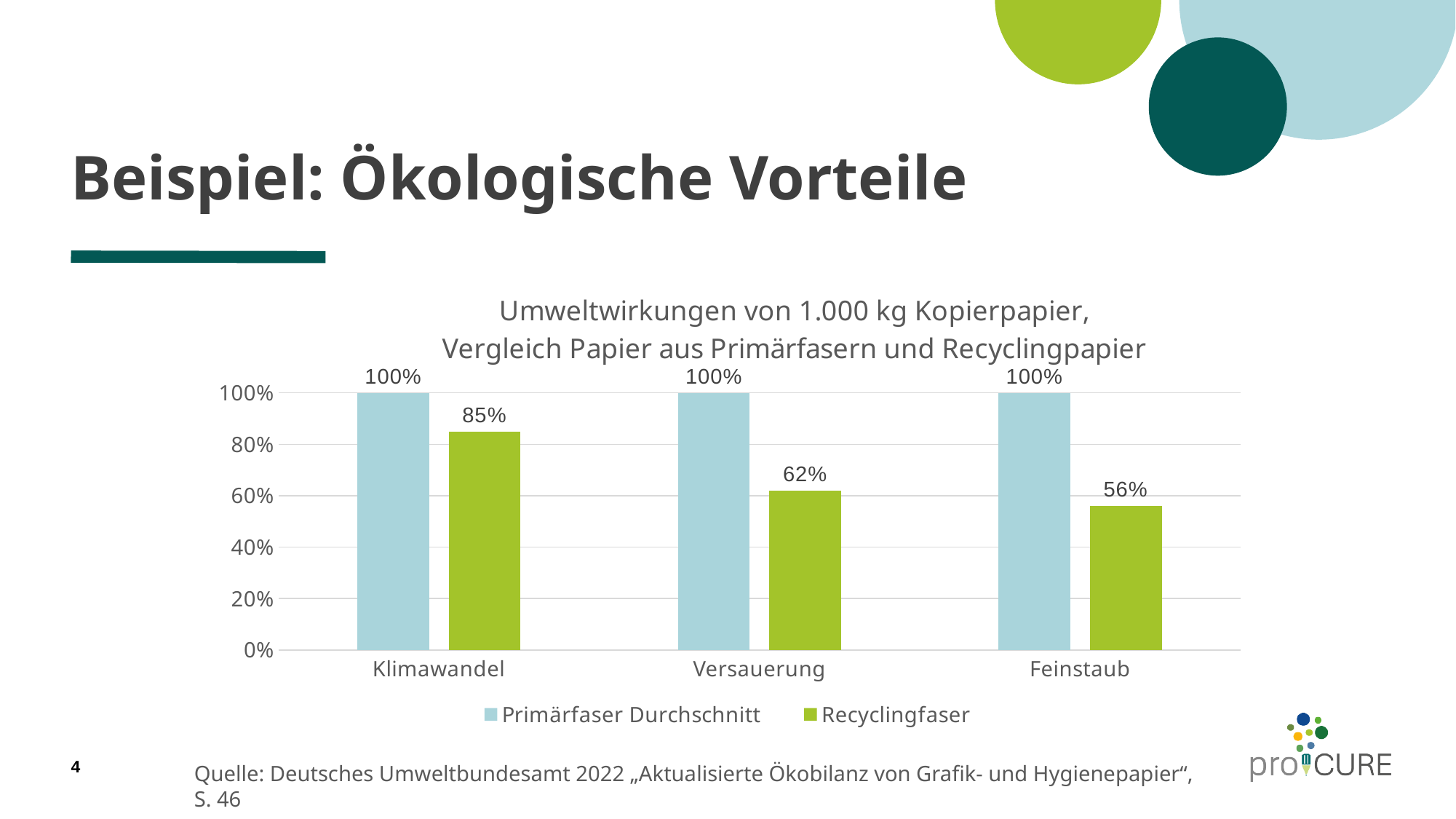
In which category is the Recyclingfaser value lowest? Feinstaub What is the value for Recyclingfaser in the Feinstaub category? 56% How many categories are shown on the x axis? 3 What is the value for Recyclingfaser in the Versauerung category? 62% Which is larger: the Recyclingfaser value for Klimawandel or for Feinstaub? Klimawandel Which series is shown in green in the chart? Recyclingfaser What is the difference between Primärfaser Durchschnitt and Recyclingfaser in the Versauerung category? 38% What is the value for Recyclingfaser in the Klimawandel category? 85% How many series does the legend list? 2 What kind of chart is shown on the slide? Bar chart In which category is the Recyclingfaser value highest? Klimawandel What is the value for Primärfaser Durchschnitt in the Feinstaub category? 100%